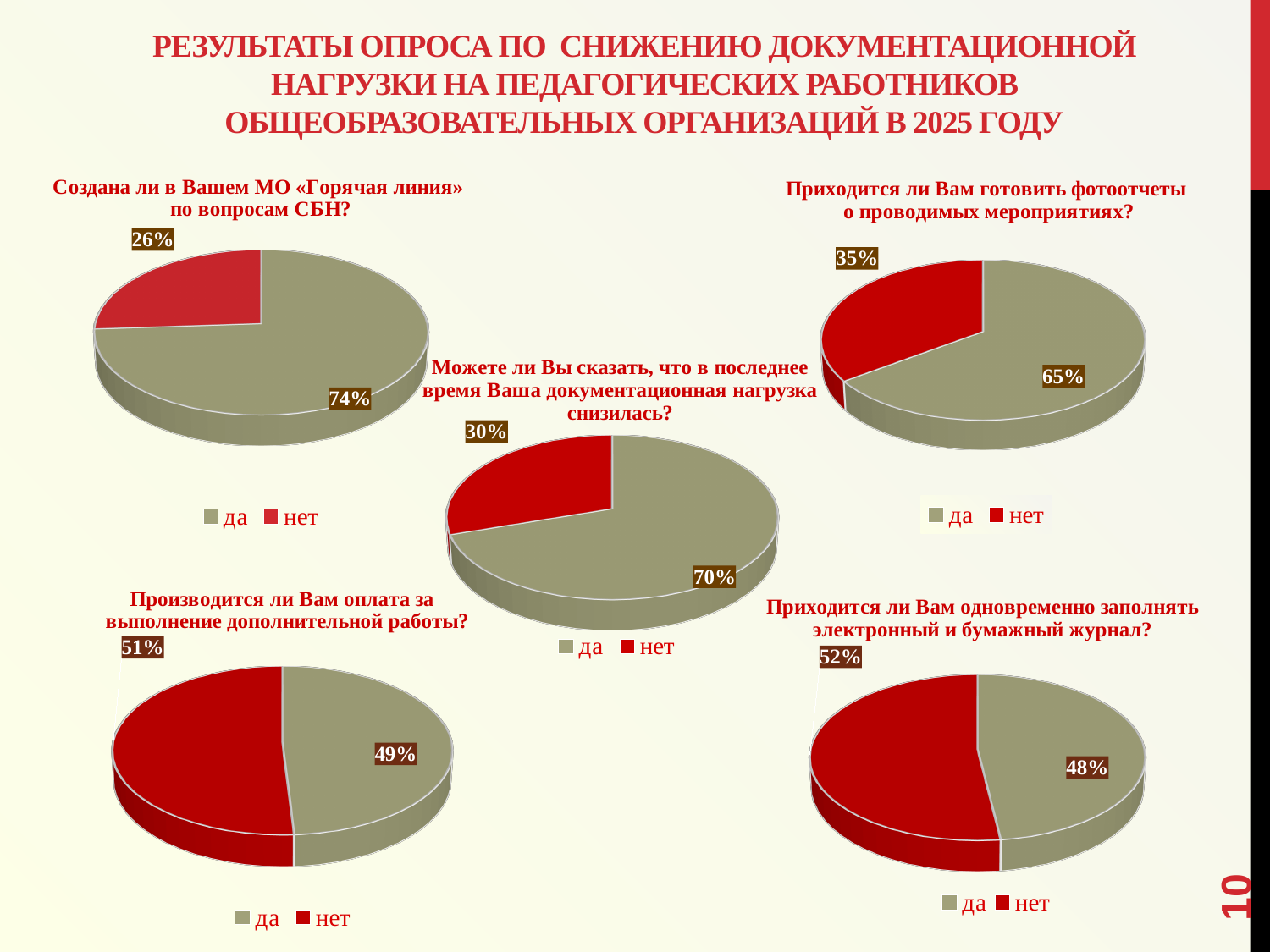
In the pie chart titled «Создана ли в Вашем МО «Горячая линия» по вопросам СБН?», what share of respondents answered «нет»? 26% In the pie chart titled «Производится ли Вам оплата за выполнение дополнительной работы?», what percentage answered «нет»? 51% In the pie chart titled «Приходится ли Вам одновременно заполнять электронный и бумажный журнал?», is the share for «да» or for «нет» larger? нет What type of chart is used for the question «Создана ли в Вашем МО «Горячая линия» по вопросам СБН?»? pie chart In the centre pie chart titled «Можете ли Вы сказать, что в последнее время Ваша документационная нагрузка снизилась?», what percentage answered «да»? 70% In the pie chart titled «Производится ли Вам оплата за выполнение дополнительной работы?», which answer has the smaller share? да How many pie charts are shown on the slide? 5 In the centre pie chart titled «Можете ли Вы сказать, что в последнее время Ваша документационная нагрузка снизилась?», what is the difference between the «да» and «нет» shares? 40% In the pie chart titled «Приходится ли Вам готовить фотоотчеты о проводимых мероприятиях?», what percentage answered «нет»? 35% In the pie chart titled «Создана ли в Вашем МО «Горячая линия» по вопросам СБН?», what share of respondents answered «да»? 74% In the pie chart titled «Приходится ли Вам готовить фотоотчеты о проводимых мероприятиях?», which answer has the larger share? да In the pie chart titled «Приходится ли Вам одновременно заполнять электронный и бумажный журнал?», what percentage answered «да»? 48%